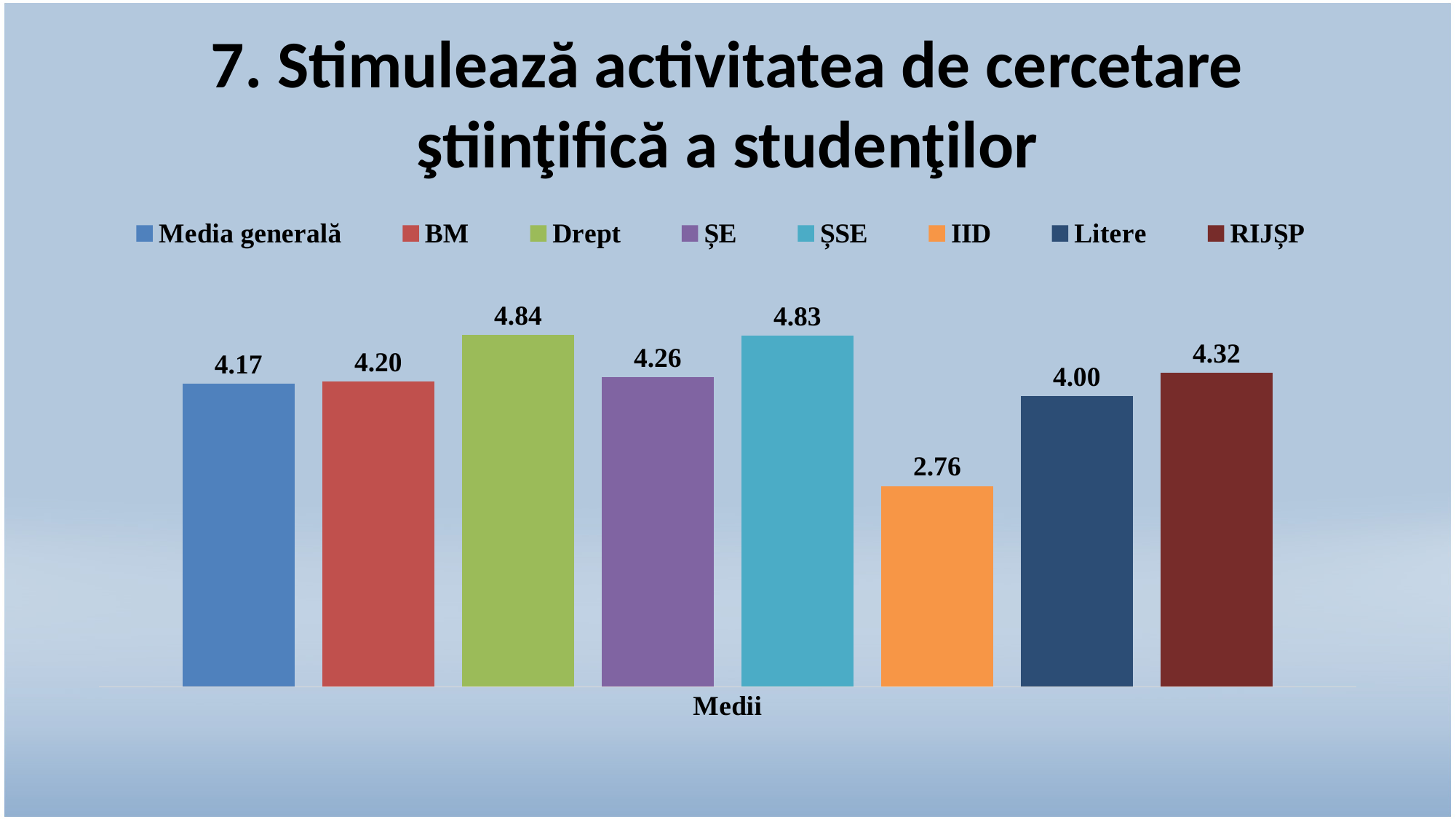
What is the difference between the values for RIJȘP and Litere? 0.32 What is the value for Media generală? 4.17 What is the value for Litere? 4.00 How many series does the legend list? 8 Which is larger, the value for ȘE or the value for BM? ȘE What is the difference between the values for Drept and IID? 2.08 What is the label shown on the x axis below the bars? Medii Which series has the lowest value? IID Which series has the highest value? Drept What is the value for IID? 2.76 What is the value for Drept? 4.84 What kind of chart is shown on the slide? Bar chart